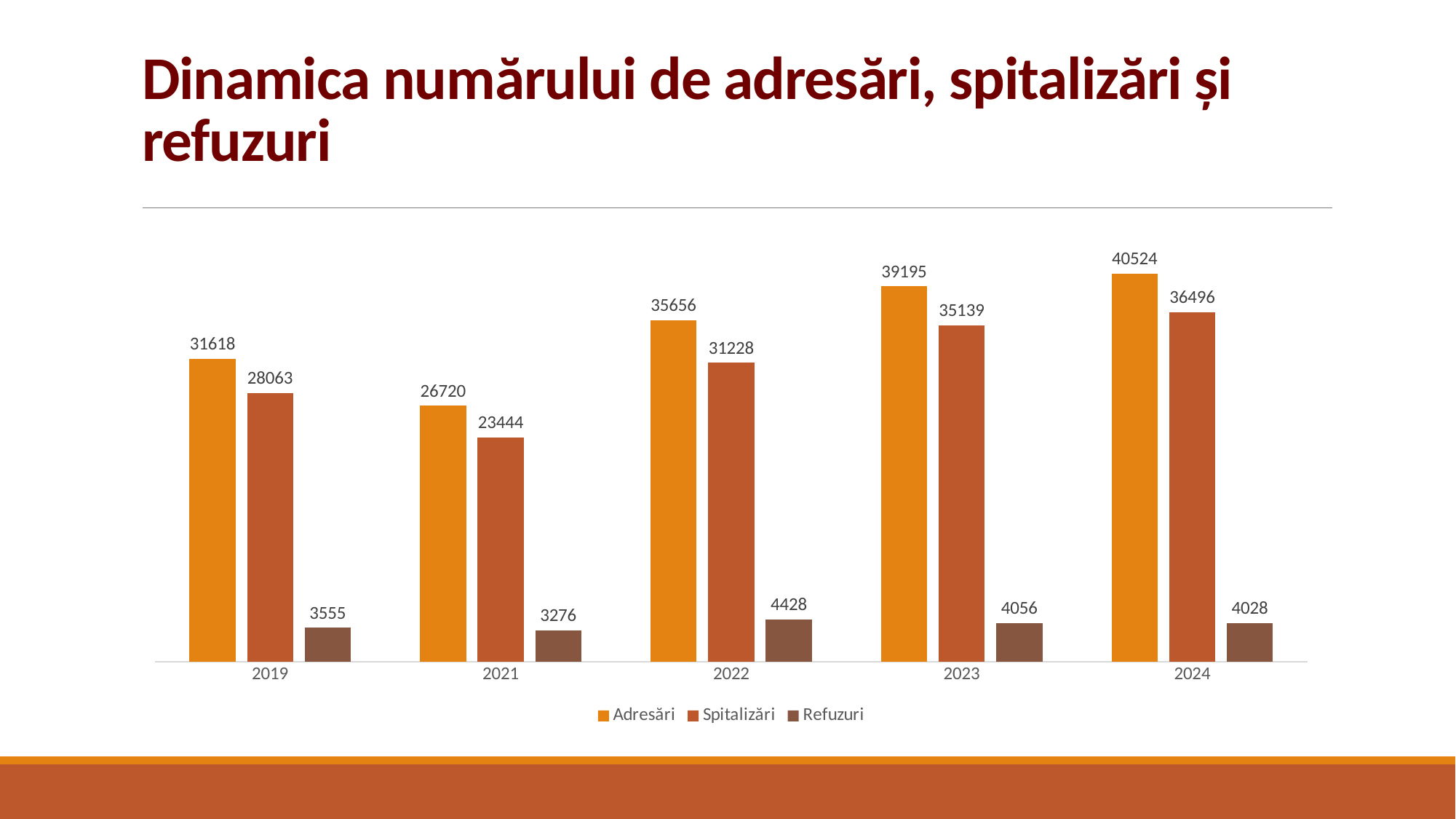
How many years are shown on the x axis? 5 Which year has the lowest value for Spitalizări? 2021 What is the value of Spitalizări for 2019? 28063 What is the difference between Adresări and Spitalizări in 2024? 4028 What kind of chart is shown on the slide? Bar chart Which is larger: Refuzuri in 2019 or Refuzuri in 2021? Refuzuri in 2019 What is the value of Refuzuri for 2023? 4056 How many series does the legend list? 3 What is the difference between Adresări in 2023 and Adresări in 2021? 12475 Which year has the highest value for Refuzuri? 2022 Which year has the highest value for Adresări? 2024 What is the value of Adresări for 2022? 35656